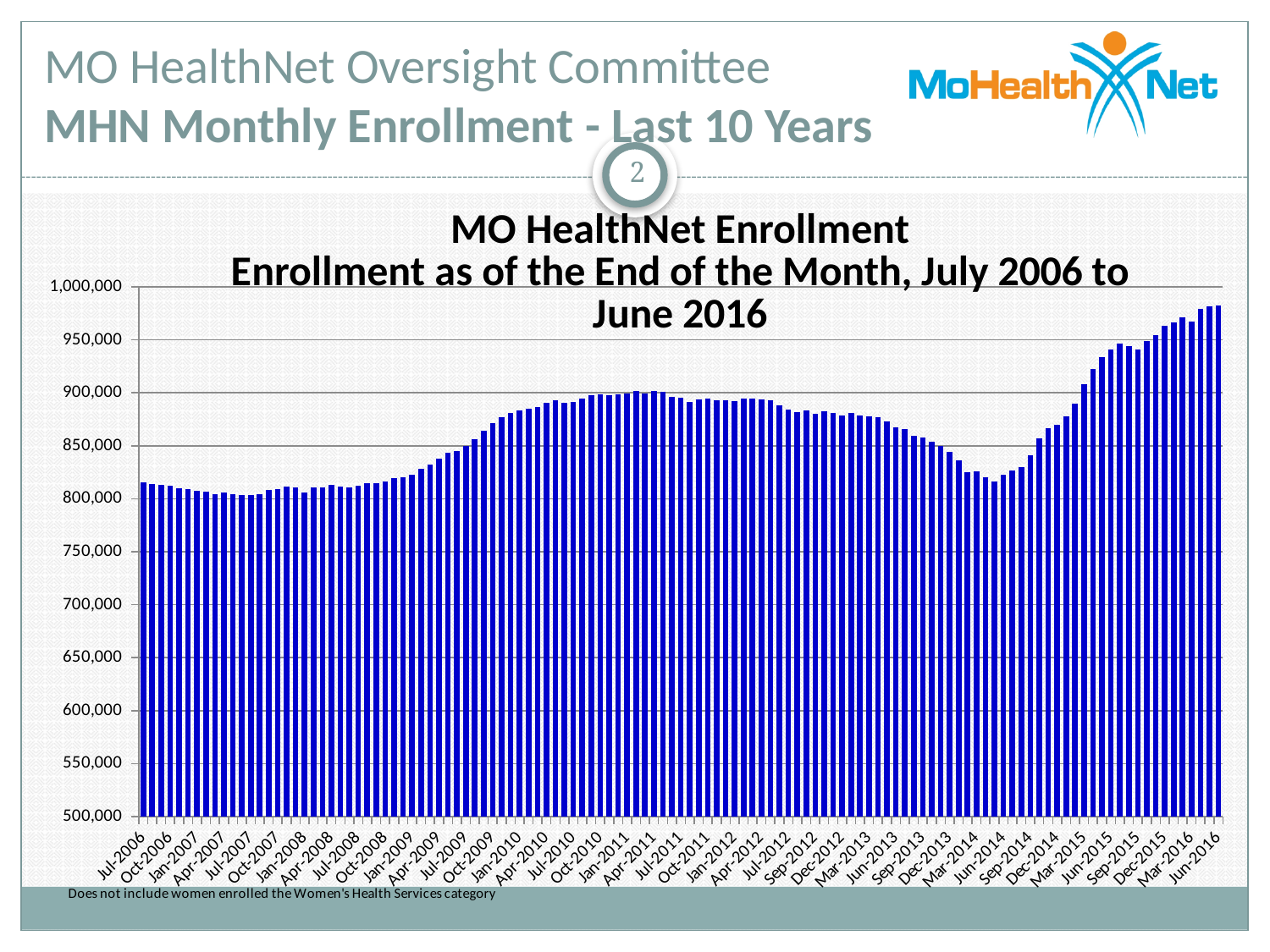
What kind of chart is shown on the slide? bar chart Is the enrollment value for Jan-2010 greater or less than 900,000? less Is the enrollment value for Jun-2015 greater or less than 900,000? greater Is the enrollment value for Jul-2006 greater or less than 800,000? greater Do the enrollment values rise or fall from Jun-2014 to Jun-2016? rise What is the lowest value shown on the vertical axis? 500,000 Which is larger, the enrollment for Jan-2011 or the enrollment for Jan-2007? Jan-2011 Which is larger, the enrollment for Jun-2016 or the enrollment for Jun-2014? Jun-2016 Which month has the highest enrollment in the chart? Jun-2016 What is the title of the chart? MO HealthNet Enrollment Enrollment as of the End of the Month, July 2006 to June 2016